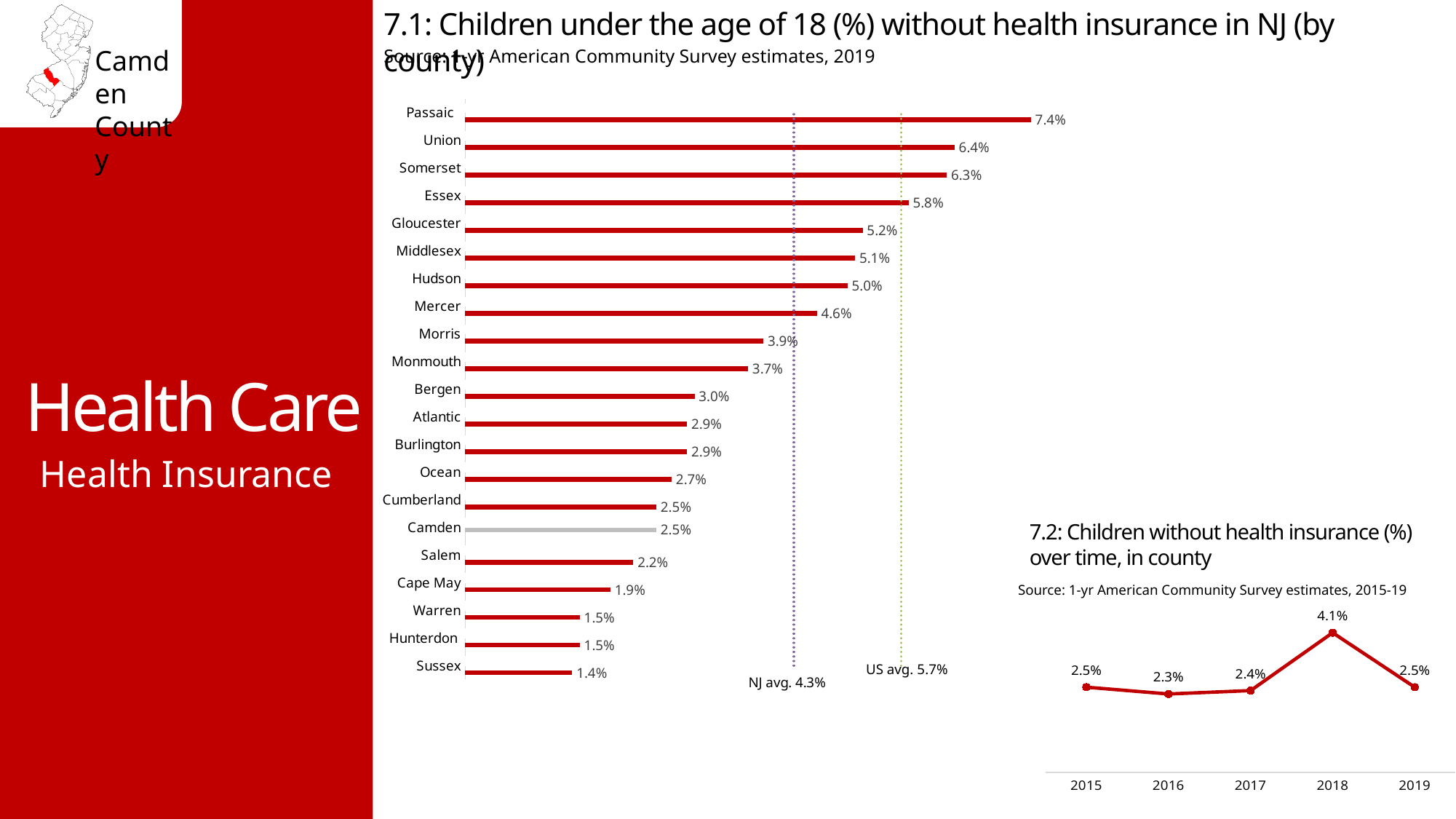
In chart 7.1 (children under 18 without health insurance by county), which county has the highest value? Passaic In chart 7.2 (children without health insurance over time, in county), what is the value for 2018? 4.1% In chart 7.1 (children under 18 without health insurance by county), what is the NJ average shown by the dotted line? 4.3% In chart 7.1 (children under 18 without health insurance by county), which is larger, the value for Essex or the value for Mercer? Essex In chart 7.1 (children under 18 without health insurance by county), what is the difference between Passaic and Sussex? 6.0% In chart 7.1 (children under 18 without health insurance by county), what kind of chart is it? Bar chart In chart 7.1 (children under 18 without health insurance by county), how many counties are shown? 21 In chart 7.1 (children under 18 without health insurance by county), what is the value for Camden? 2.5% In chart 7.1 (children under 18 without health insurance by county), which county has the lowest value? Sussex In chart 7.2 (children without health insurance over time, in county), which year has the lowest value? 2016 In chart 7.1 (children under 18 without health insurance by county), what is the value for Passaic? 7.4% In chart 7.2 (children without health insurance over time, in county), what is the difference between 2018 and 2019? 1.6%